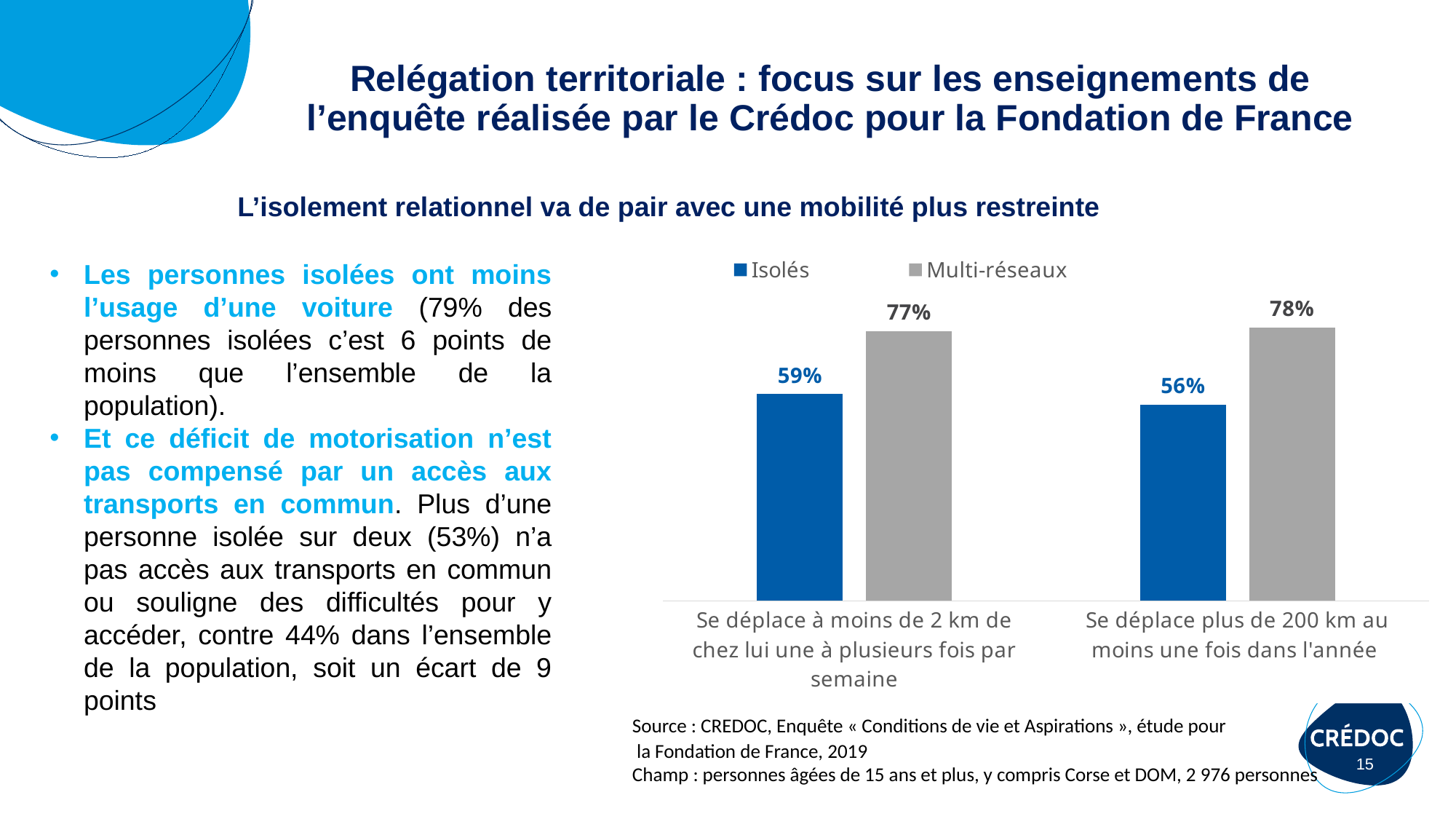
What is the value for Multi-réseaux in the category 'Se déplace à moins de 2 km de chez lui une à plusieurs fois par semaine'? 77% Which series has the highest value in the chart? Multi-réseaux What is the value for Multi-réseaux in the category 'Se déplace plus de 200 km au moins une fois dans l'année'? 78% What is the difference between Multi-réseaux and Isolés for 'Se déplace à moins de 2 km de chez lui une à plusieurs fois par semaine'? 18 points What is the value for Isolés in the category 'Se déplace à moins de 2 km de chez lui une à plusieurs fois par semaine'? 59% Which is larger for 'Se déplace à moins de 2 km de chez lui une à plusieurs fois par semaine': Isolés or Multi-réseaux? Multi-réseaux What kind of chart is shown on the slide? Bar chart How many series does the legend list? 2 How many categories are shown on the x axis of the chart? 2 Which bar has the lowest value in the chart? Isolés, Se déplace plus de 200 km au moins une fois dans l'année What is the value for Isolés in the category 'Se déplace plus de 200 km au moins une fois dans l'année'? 56% What is the difference between Multi-réseaux and Isolés for 'Se déplace plus de 200 km au moins une fois dans l'année'? 22 points